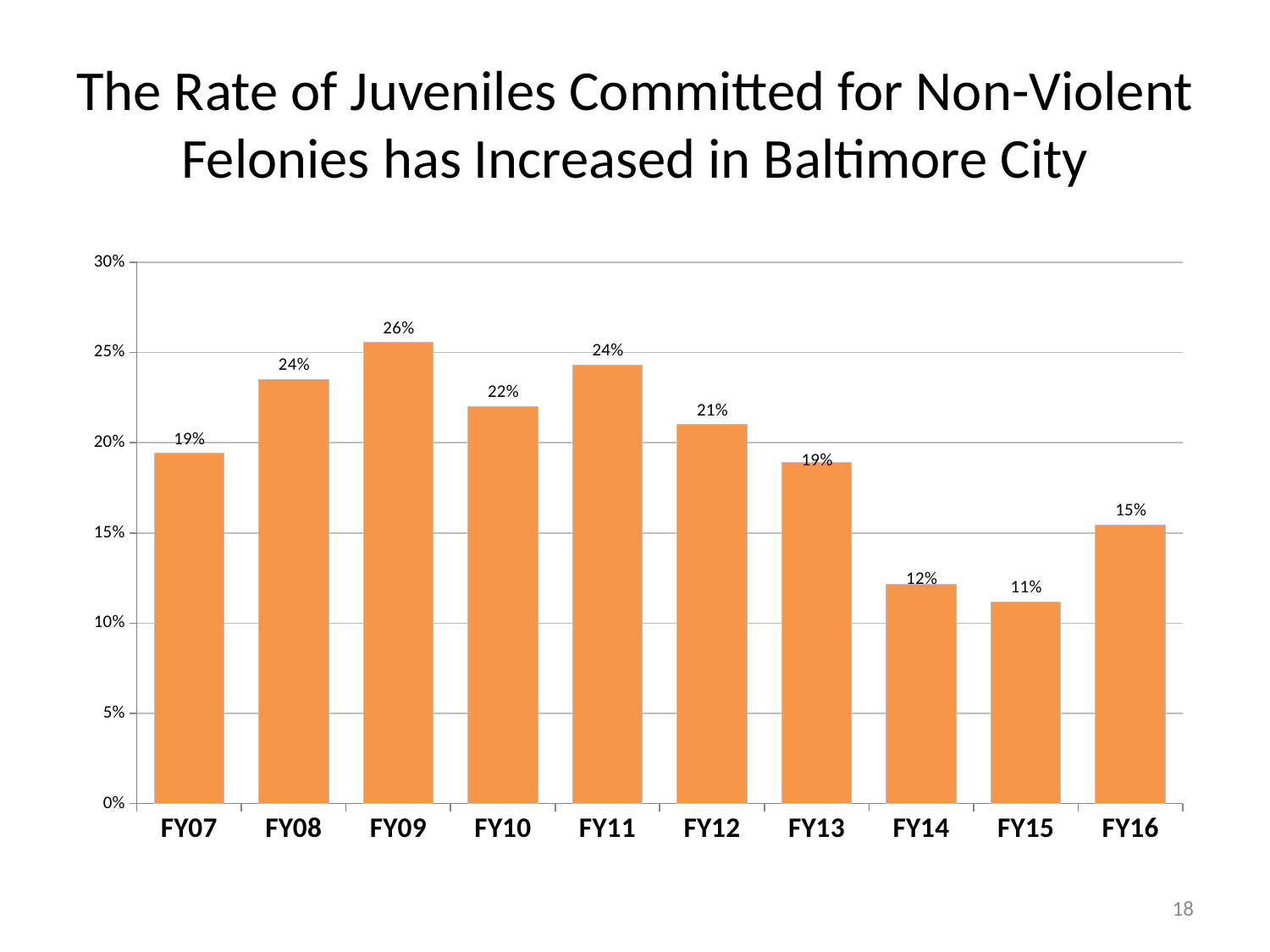
Which fiscal year has the lowest value? FY15 What is the value for FY14? 12% What is the value for FY16? 15% Is the value for FY13 greater or less than 20%? less Which fiscal year has the highest value? FY09 What is the difference between the values for FY09 and FY15? 15 percentage points What is the difference between the values for FY16 and FY15? 4 percentage points What kind of chart is shown on the slide? bar chart What is the value for FY09? 26% How many fiscal years are shown on the x axis? 10 Which is larger, the value for FY10 or the value for FY12? FY10 Do the values rise or fall from FY11 to FY15? fall